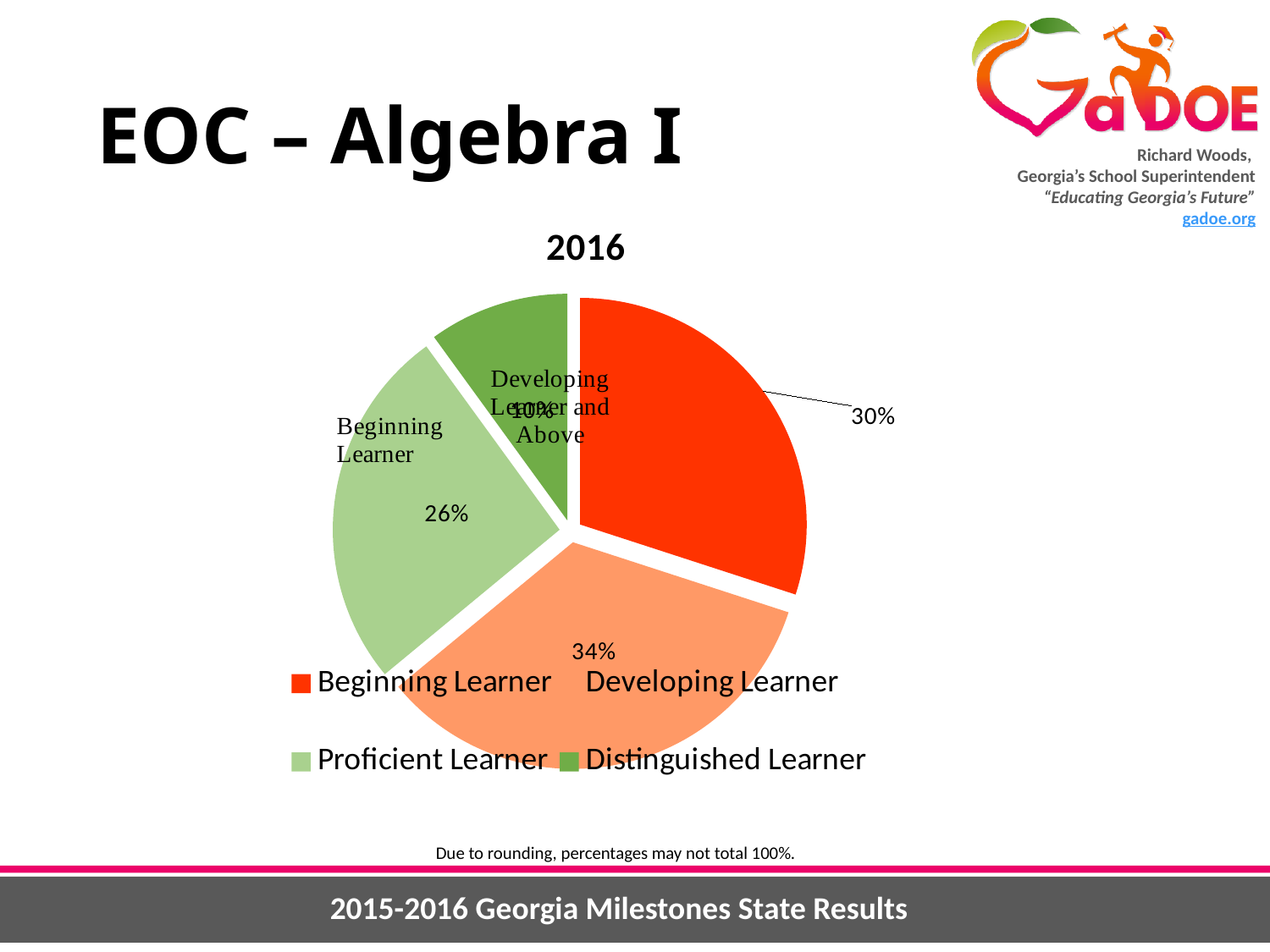
Which is larger, the Beginning Learner slice or the Proficient Learner slice? Beginning Learner What is the difference in percentage points between Developing Learner and Proficient Learner? 8 Which category has the largest slice of the pie? Developing Learner How many categories does the legend list? 4 What is the title of the chart? 2016 What kind of chart is shown on the slide? pie chart What percentage of the pie is Beginning Learner? 30% Is the Distinguished Learner slice greater or less than 20% of the pie? less What percentage of the pie is Proficient Learner? 26% What percentage of the pie is Developing Learner? 34% Which category has the smallest slice of the pie? Distinguished Learner How many slices does the pie chart have? 4